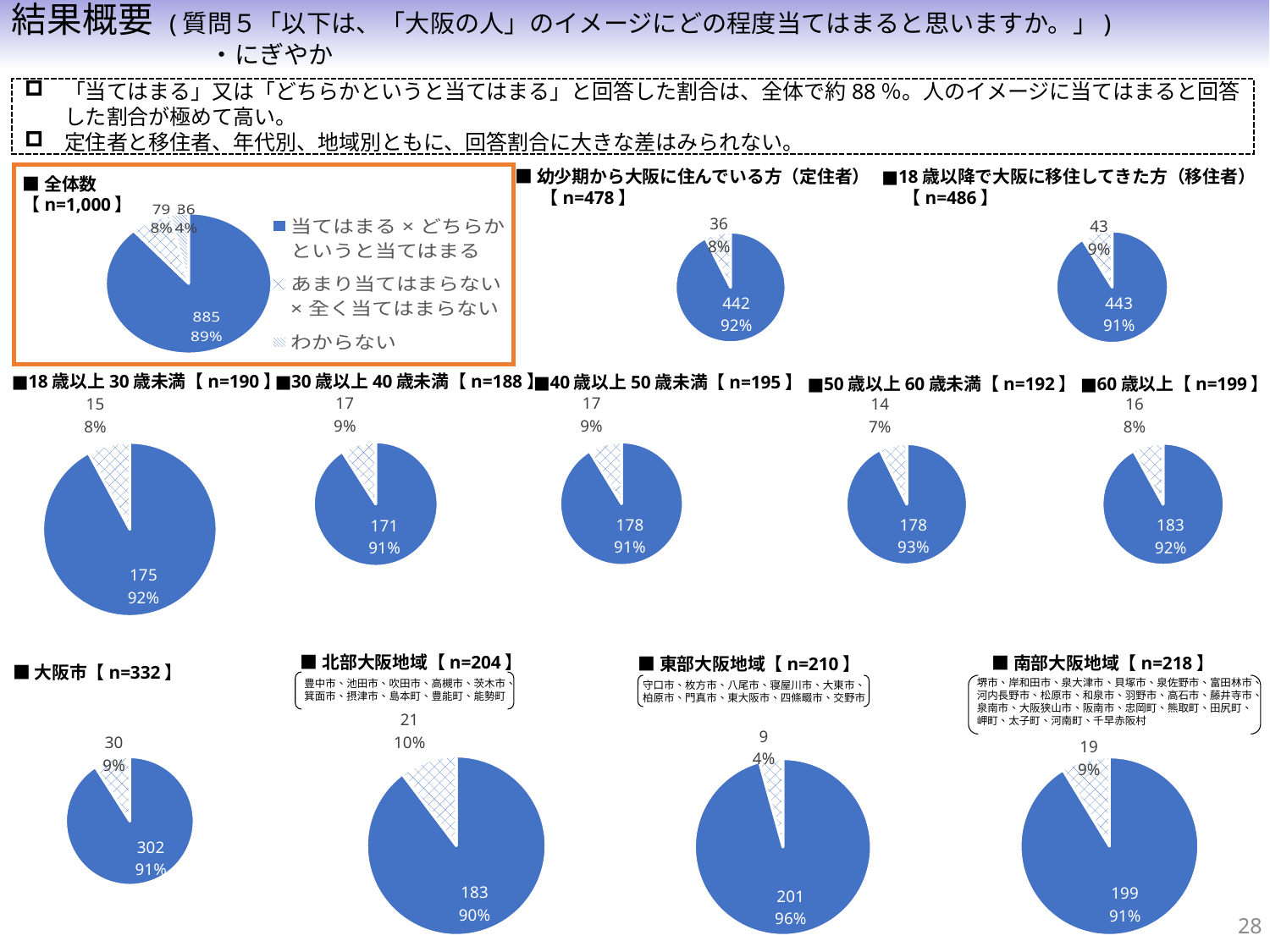
In the 東部大阪地域【n=210】 pie chart, what is the value of the small slice? 9 What is the difference between the blue slice value in the 北部大阪地域【n=204】 chart and the small slice value in the same chart? 162 In the 幼少期から大阪に住んでいる方（定住者）【n=478】 pie chart, what is the value of the largest slice? 442 What type of chart is used for the 幼少期から大阪に住んでいる方（定住者）【n=478】 data? pie chart In the 50歳以上60歳未満【n=192】 pie chart, what percentage does the large blue slice show? 93% In the 全体数【n=1,000】 pie chart, what percentage is shown for わからない? 4% In the 全体数【n=1,000】 pie chart, how many respondents answered 当てはまる×どちらかというと当てはまる? 885 In the 18歳以降で大阪に移住してきた方（移住者）【n=486】 pie chart, what percentage is shown for the smaller slice? 9% In the 60歳以上【n=199】 pie chart, what is the value of the blue slice? 183 Which is larger: the blue slice value in the 大阪市【n=332】 chart or the blue slice value in the 南部大阪地域【n=218】 chart? 大阪市【n=332】 In the 全体数【n=1,000】 pie chart, what percentage share does the 当てはまる×どちらかというと当てはまる slice have? 89% How many entries does the legend of the 全体数【n=1,000】 chart list? 3